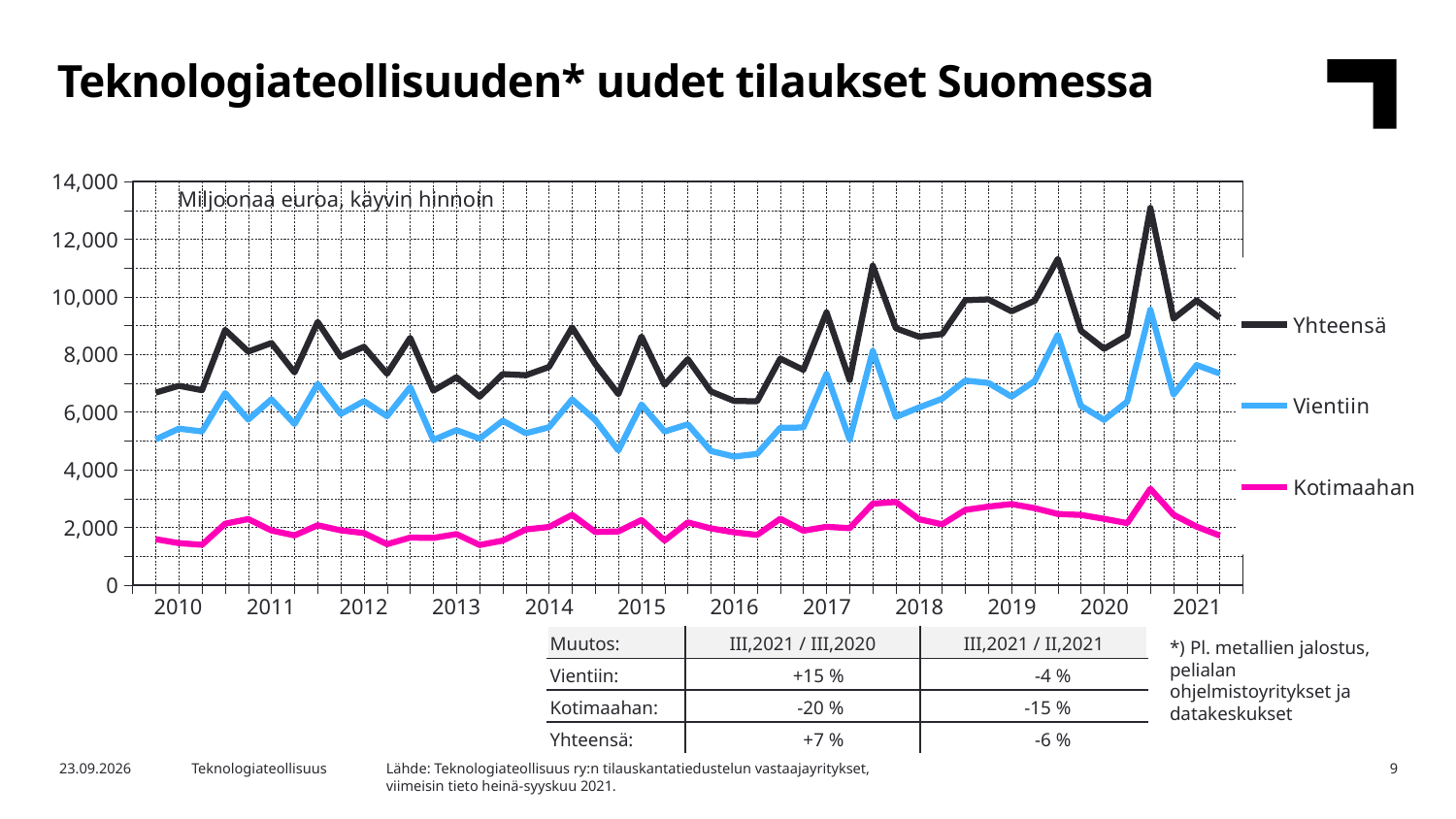
Which series has the highest values throughout the chart? Yhteensä Is the highest point of the Vientiin line greater or less than 8,000? greater Is the highest point of the Kotimaahan line greater or less than 4,000? less How many years are labelled on the x axis of the chart? 12 Which series has the lowest values throughout the chart? Kotimaahan Which series is larger at the end of 2021, Vientiin or Kotimaahan? Vientiin How many series does the chart legend list? 3 What kind of chart is shown on the slide? line chart Is the highest point of the Yhteensä line greater or less than 12,000? greater What unit label is printed inside the chart area? Miljoonaa euroa, käyvin hinnoin Which series is drawn in black in the chart? Yhteensä Does the Kotimaahan line rise or fall from its 2020 peak to the end of 2021? fall